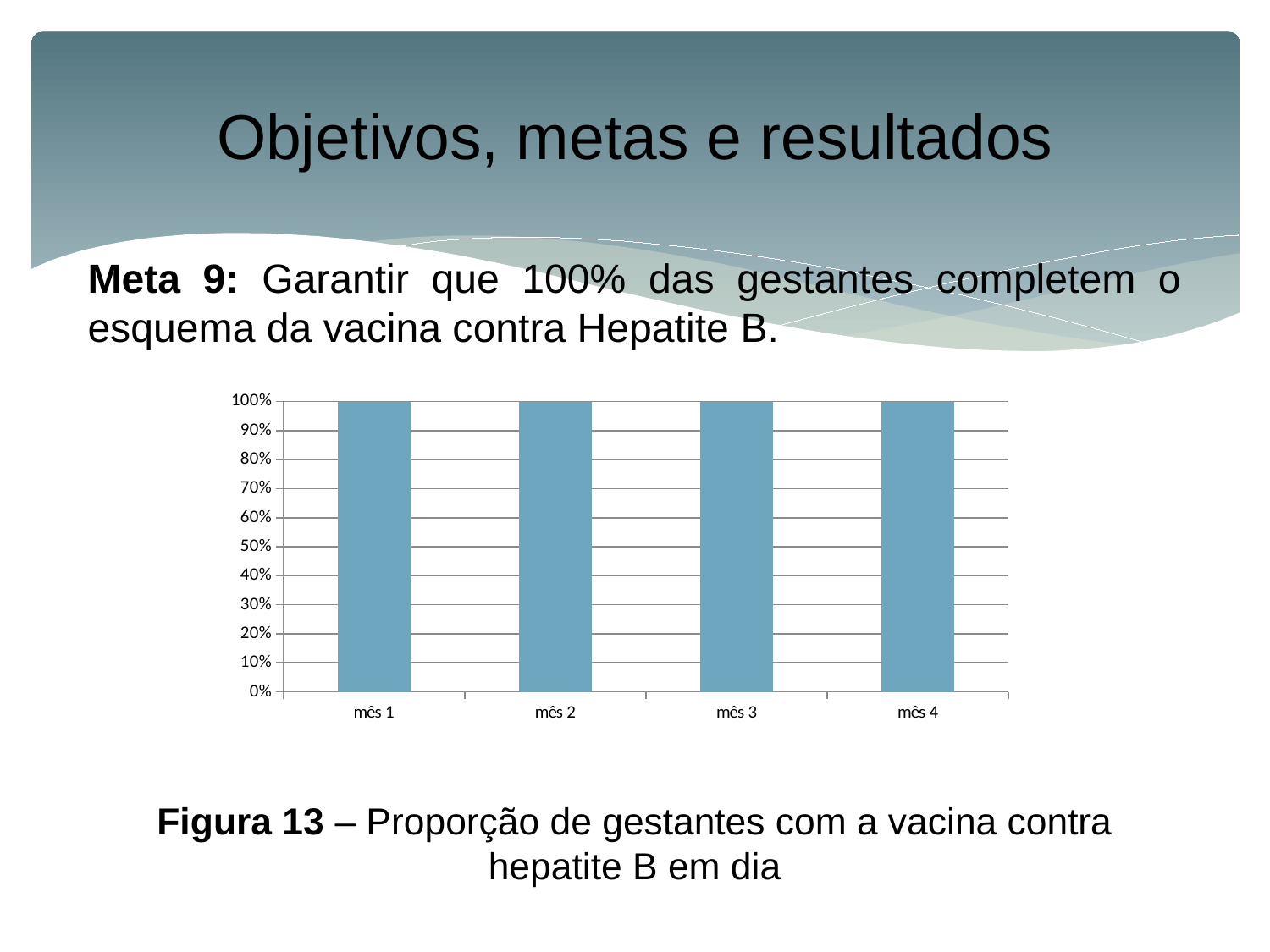
Is the value for mês 2 greater or less than 50%? greater What is the highest value shown on the y axis? 100% What is the value for mês 1? 100% What kind of chart is shown on the slide? bar chart How many categories are shown on the x axis? 4 Is the value for mês 4 greater or less than 90%? greater Do the values rise, fall or stay the same from mês 1 to mês 4? stay the same What is the figure number given in the caption below the chart? Figura 13 What is the difference between the values for mês 1 and mês 2? 0% What is the value for mês 4? 100% What is the value for mês 3? 100%